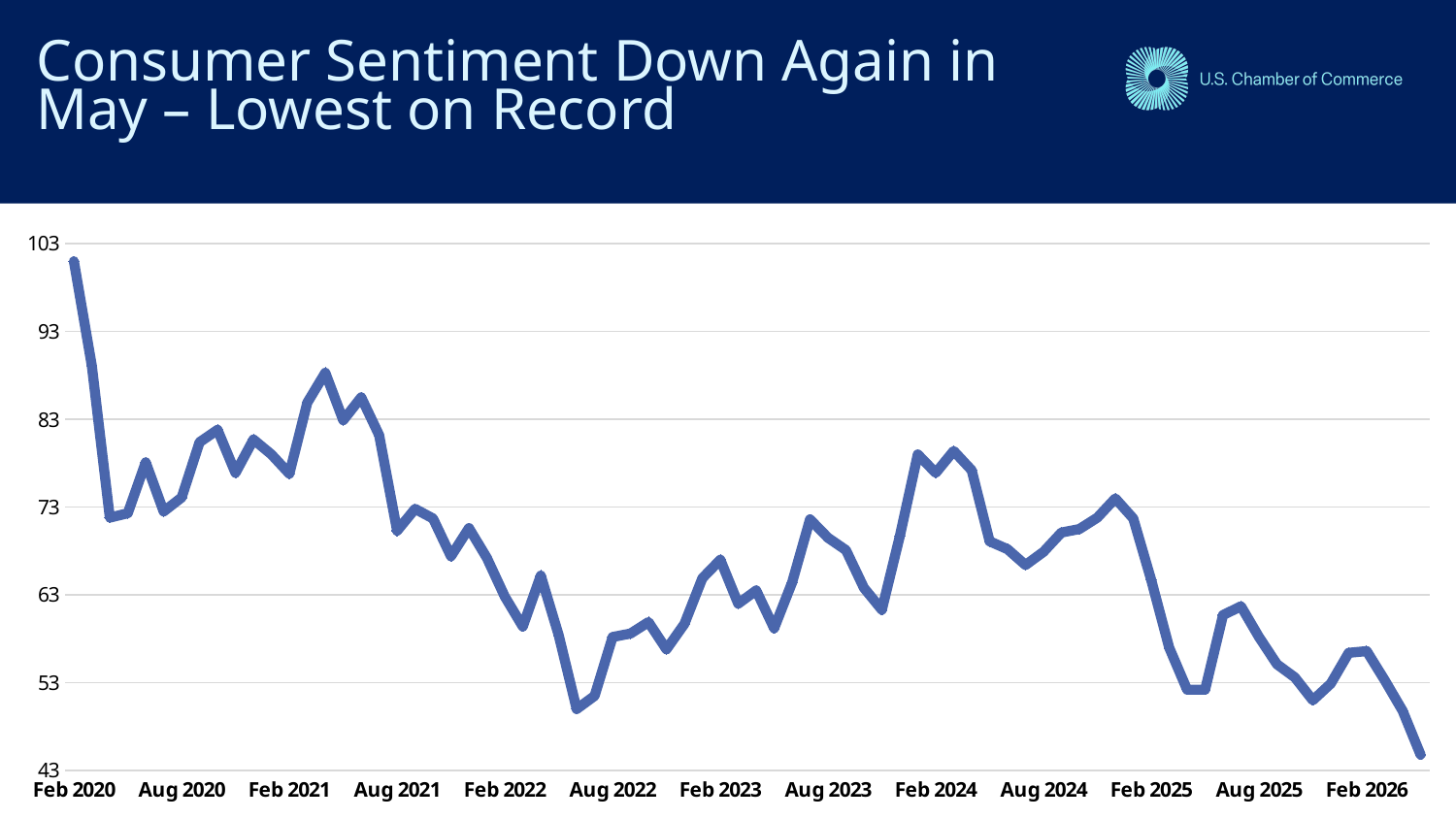
What is the title of the slide? Consumer Sentiment Down Again in May – Lowest on Record Which is larger, the value for Feb 2020 or the value for Feb 2026? Feb 2020 At which labelled date on the x axis is the value highest? Feb 2020 Is the value at the final point of the line greater or less than 53? less Is the value for Aug 2022 greater or less than 63? less What kind of chart is shown on the slide? line chart Overall, do the values rise or fall from Feb 2020 to the end of the series? fall Is the value for Feb 2024 greater or less than 73? greater How many date labels are shown on the x axis? 13